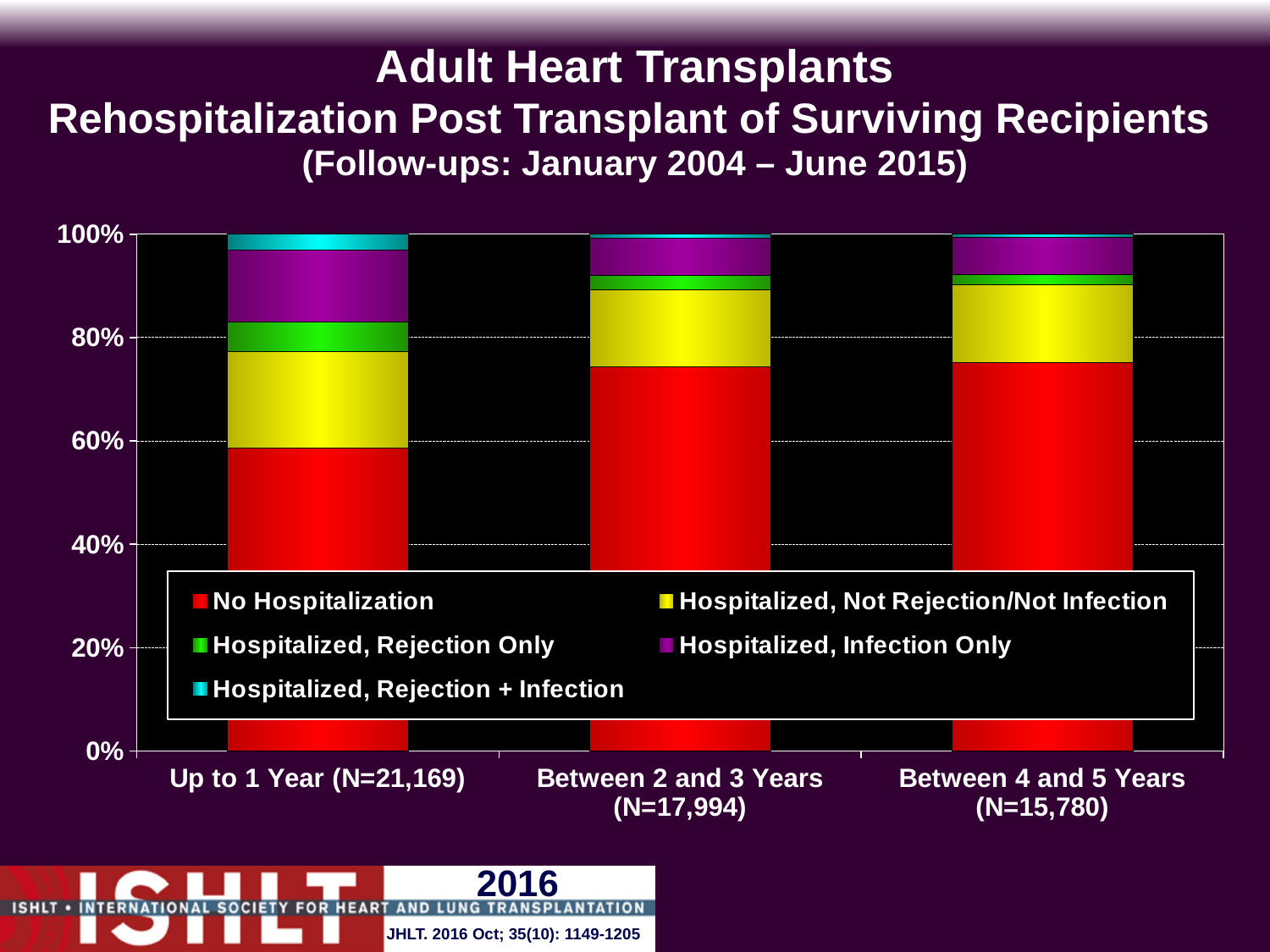
Which is larger: the No Hospitalization share for Up to 1 Year or for Between 2 and 3 Years? Between 2 and 3 Years Which follow-up category has the smallest No Hospitalization share? Up to 1 Year (N=21,169) How many series does the legend list? 5 Is the No Hospitalization share for Up to 1 Year greater or less than 40%? greater What kind of chart is shown on the slide? Stacked bar chart Which colour represents No Hospitalization in the legend? Red Does the No Hospitalization share rise or fall from Up to 1 Year to Between 4 and 5 Years? Rise Which follow-up category has the largest Hospitalized, Infection Only share? Up to 1 Year (N=21,169) Is the No Hospitalization share for Between 4 and 5 Years greater or less than 80%? less How many follow-up time categories are shown on the x axis? 3 What is the N shown for the Up to 1 Year category? 21,169 Is the No Hospitalization share for Between 2 and 3 Years greater or less than 60%? greater